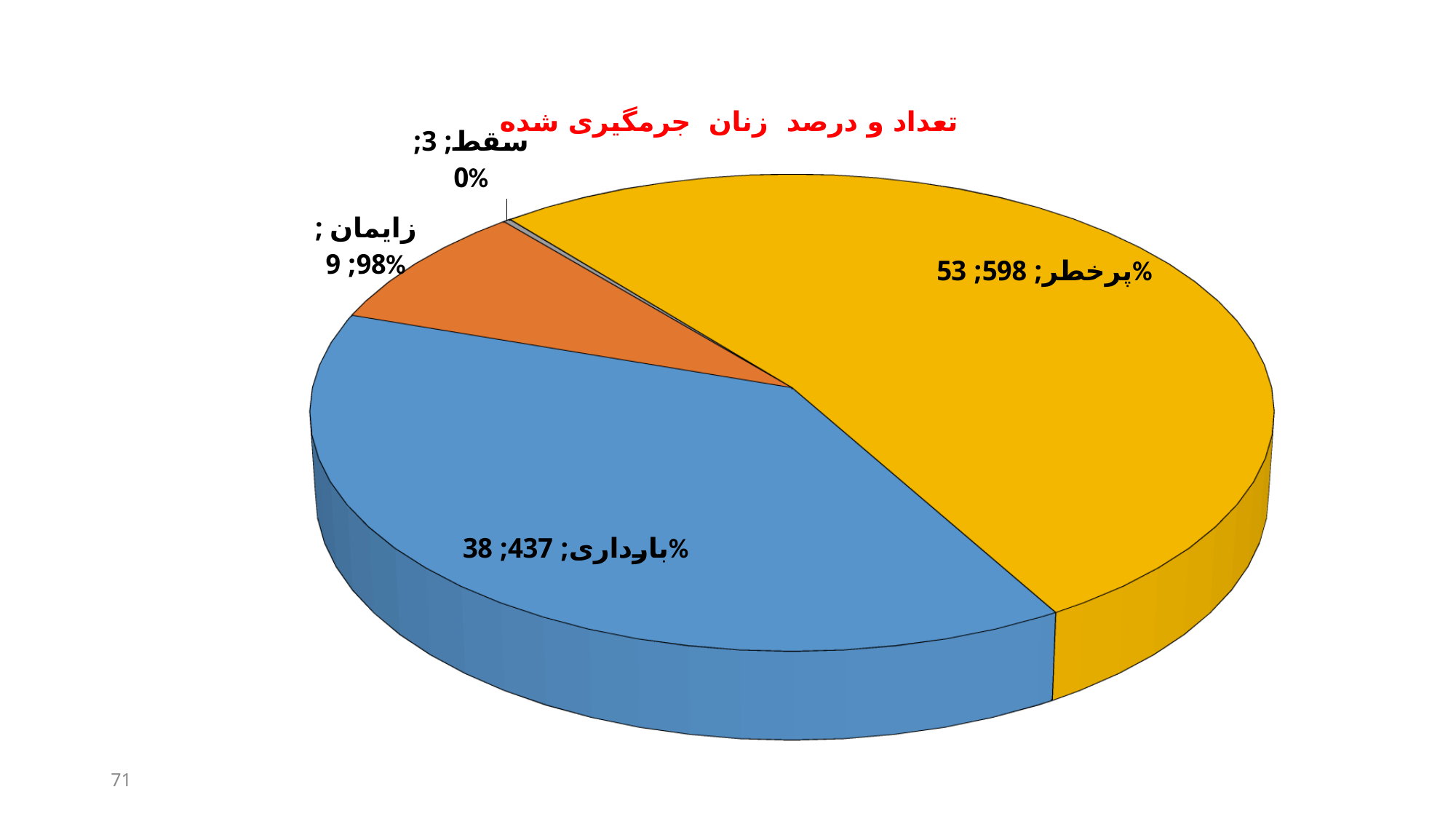
What percentage is shown for the زایمان slice? 9% What is the title of the chart? تعداد و درصد زنان جرمگیری شده How many slices does the pie chart have? 4 What percentage is shown for the بارداری slice? 38% What is the difference between the counts for پرخطر and بارداری? 161 What is the count shown for the سقط slice? 3 What percentage is shown for the پرخطر slice? 53% What kind of chart is shown on the slide? pie chart What is the count shown for the بارداری slice? 437 Which category has the smallest slice of the pie? سقط What is the count shown for the پرخطر slice? 598 Which category has the largest slice of the pie? پرخطر